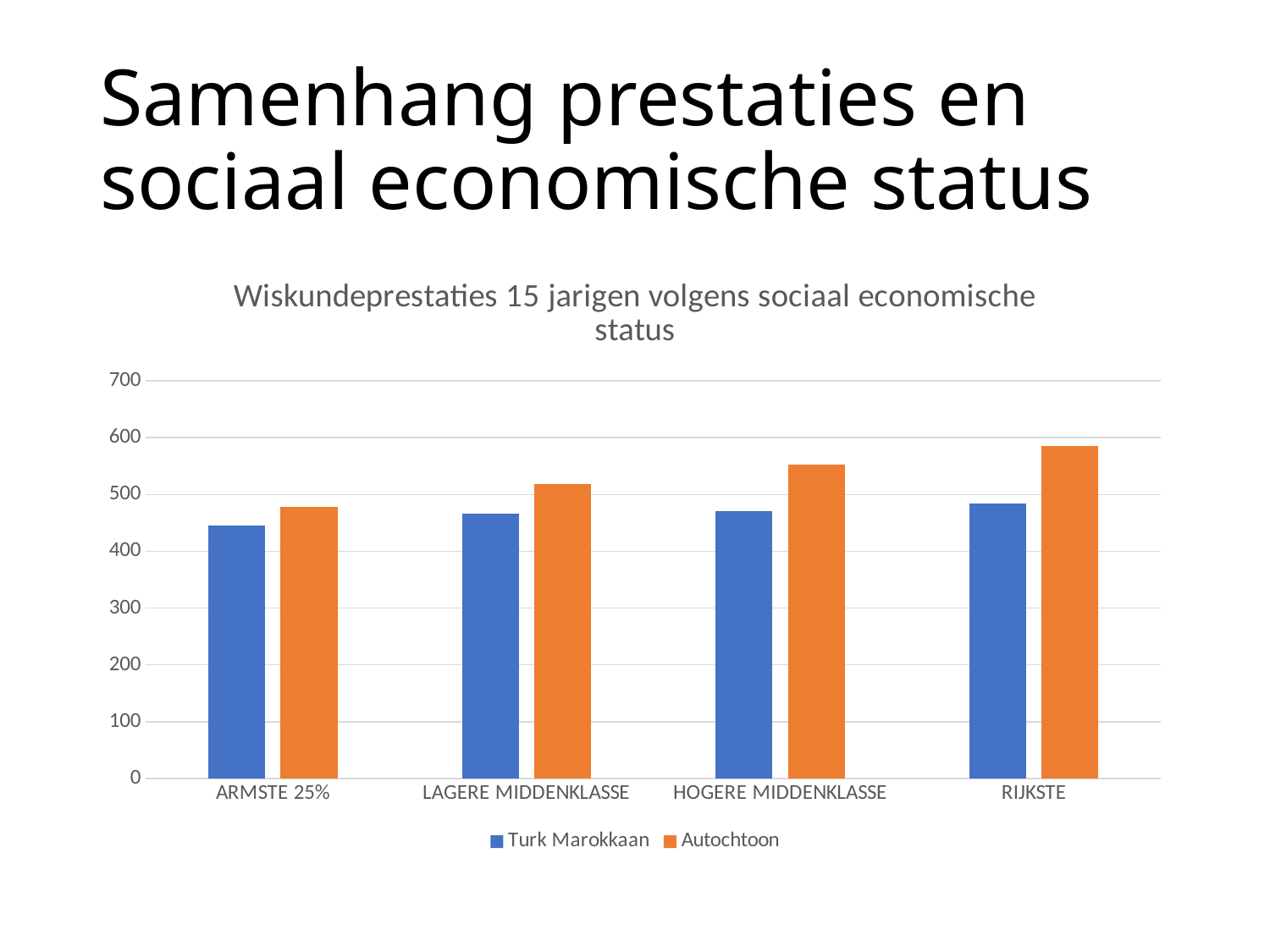
Which category has the lowest Turk Marokkaan value? ARMSTE 25% Which category has the highest Autochtoon value? RIJKSTE Is the Turk Marokkaan value for ARMSTE 25% greater or less than 500? less Is the Autochtoon value for HOGERE MIDDENKLASSE greater or less than 500? greater For RIJKSTE, which series has the larger value, Turk Marokkaan or Autochtoon? Autochtoon How many categories are shown on the x axis? 4 Is the Autochtoon value for RIJKSTE greater or less than 500? greater What kind of chart is shown on the slide? bar chart What is the title of the chart? Wiskundeprestaties 15 jarigen volgens sociaal economische status Do the Autochtoon values rise or fall from ARMSTE 25% to RIJKSTE? rise How many series does the legend list? 2